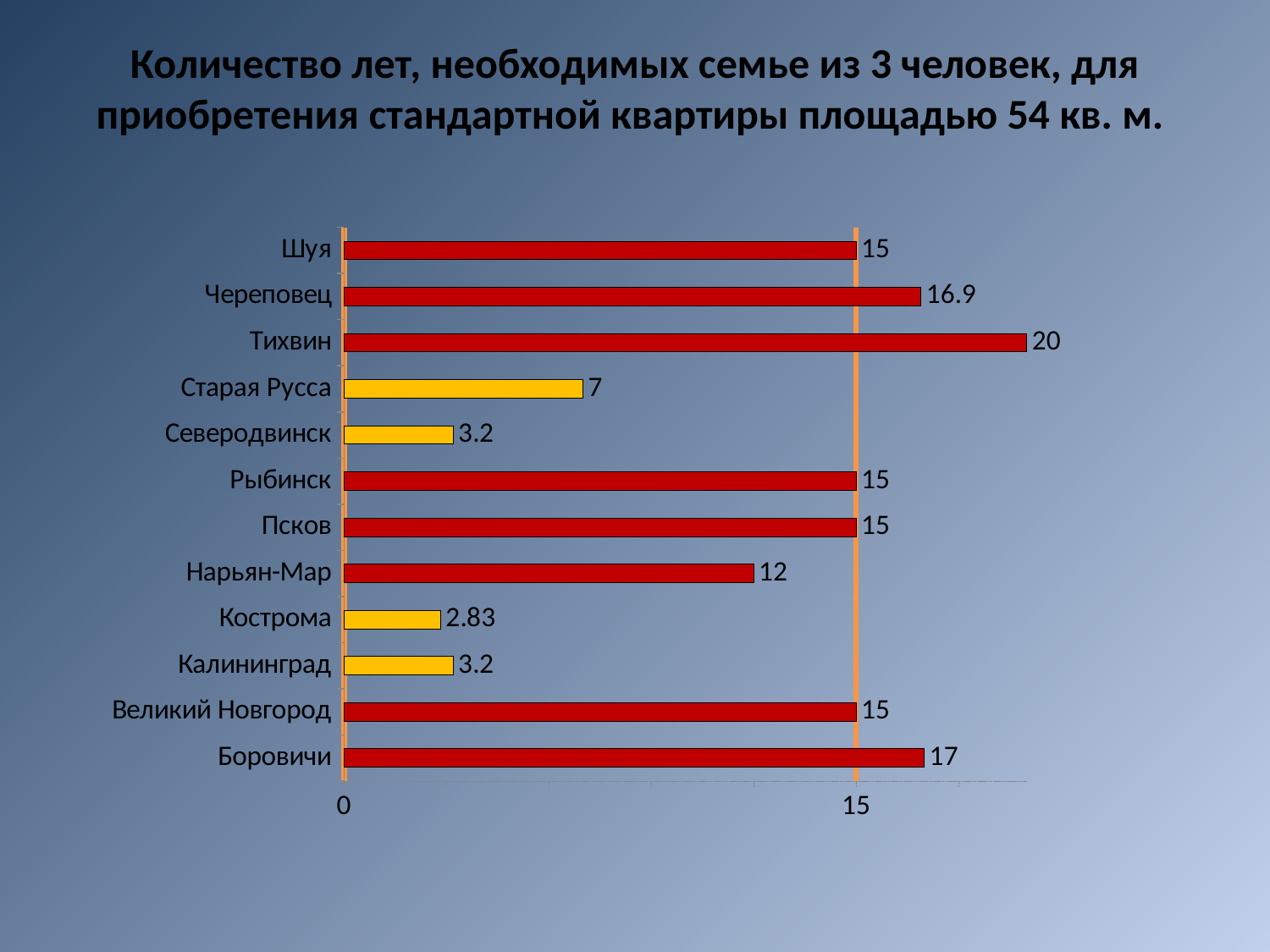
What is the value for Кострома? 2.83 What is the difference between the values for Тихвин and Боровичи? 3 What kind of chart is shown on the slide? bar chart How many bars are coloured yellow rather than red? 4 What is the value for Нарьян-Мар? 12 What is the value for Тихвин? 20 Is the value for Старая Русса greater or less than 15? less Which city has the highest value? Тихвин Which city has the lowest value? Кострома What is the value for Череповец? 16.9 How many cities are shown in the chart? 12 Which is larger, the value for Череповец or the value for Боровичи? Боровичи